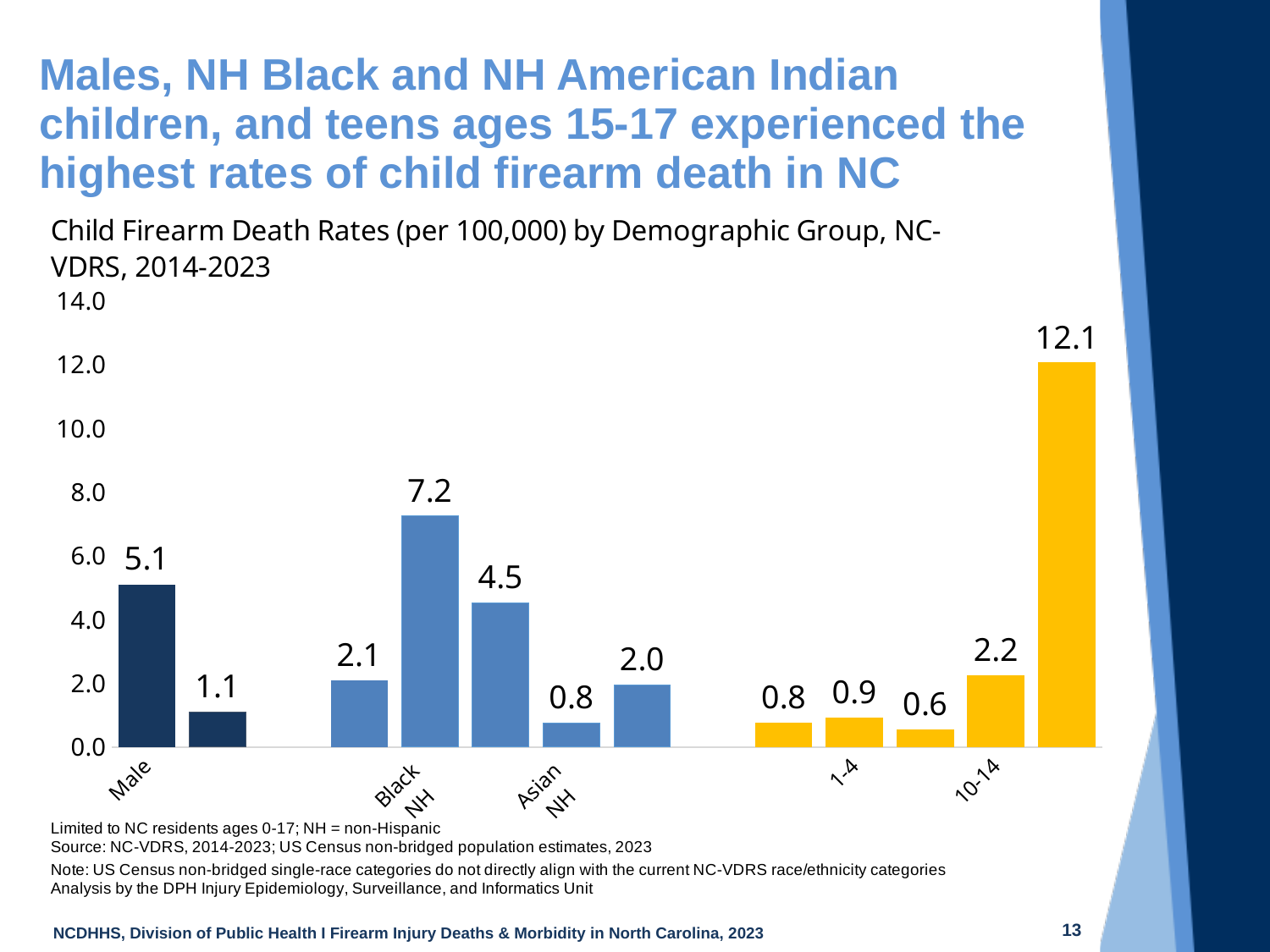
Which has a higher rate, Male or Black NH? Black NH How much higher is the rate for Black NH than for Male? 2.1 What is the child firearm death rate for Asian NH? 0.8 What is the child firearm death rate for ages 1-4? 0.9 What is the child firearm death rate for ages 10-14? 2.2 What is the child firearm death rate for Male? 5.1 How many bars are plotted in the chart? 12 What is the difference between the rates for ages 10-14 and ages 1-4? 1.3 What is the highest value shown in the chart? 12.1 Which has a higher rate, Asian NH or ages 1-4? 1-4 What is the child firearm death rate for Black NH? 7.2 What kind of chart is shown on the slide? bar chart